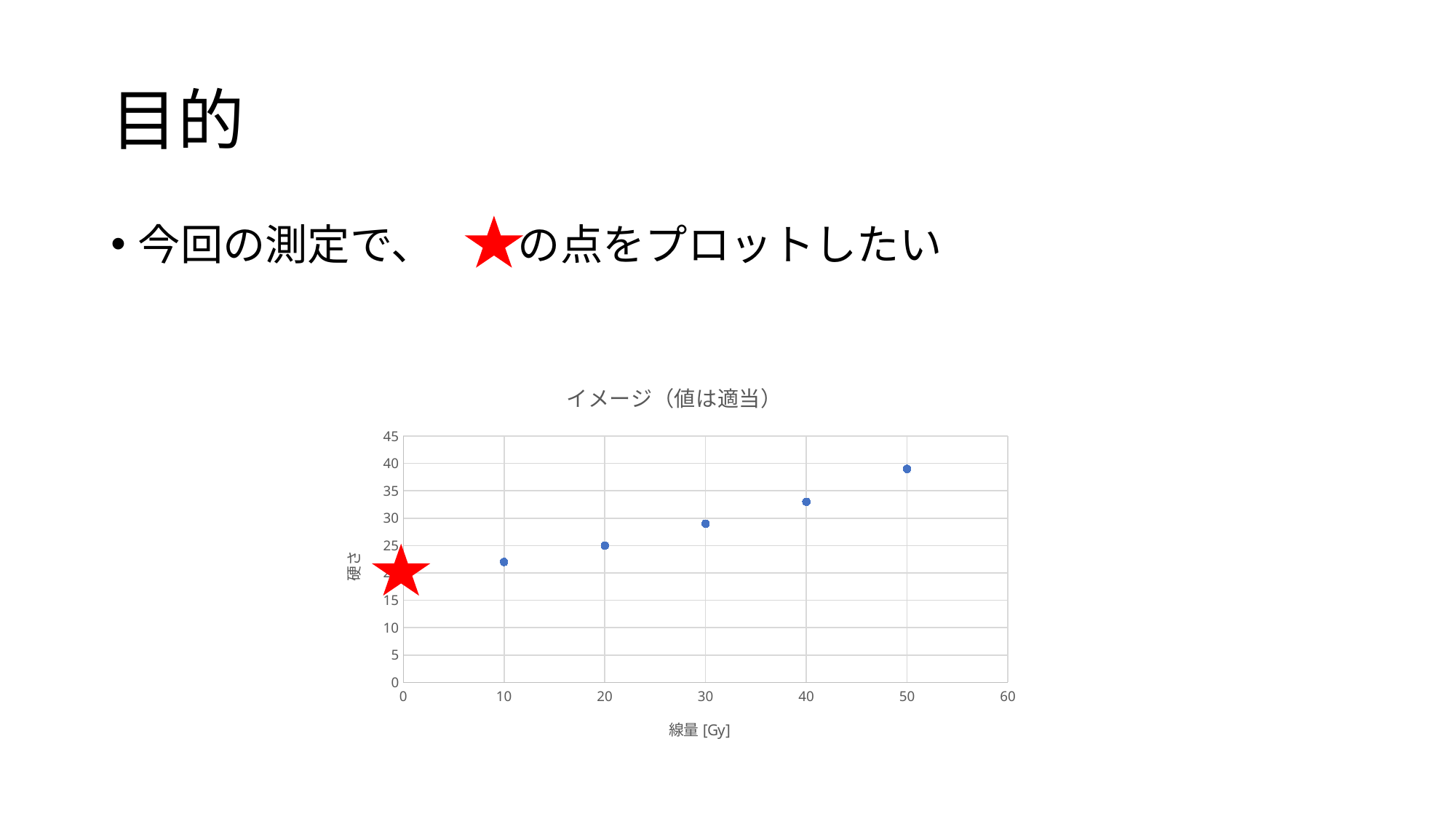
Do the plotted values rise or fall as 線量 [Gy] increases along the x axis? rise Is the 硬さ value at 線量 10 Gy greater or less than 20? greater What is the title of the chart? イメージ（値は適当） Which has the larger 硬さ value: the point at 線量 40 Gy or the point at 線量 20 Gy? 40 Gy What is the label of the x axis of the chart? 線量 [Gy] Is the 硬さ value at 線量 30 Gy greater or less than 25? greater At which 線量 [Gy] value is the plotted 硬さ highest? 50 Is the 硬さ value at 線量 50 Gy greater or less than 35? greater What kind of chart is shown on the slide? scatter chart